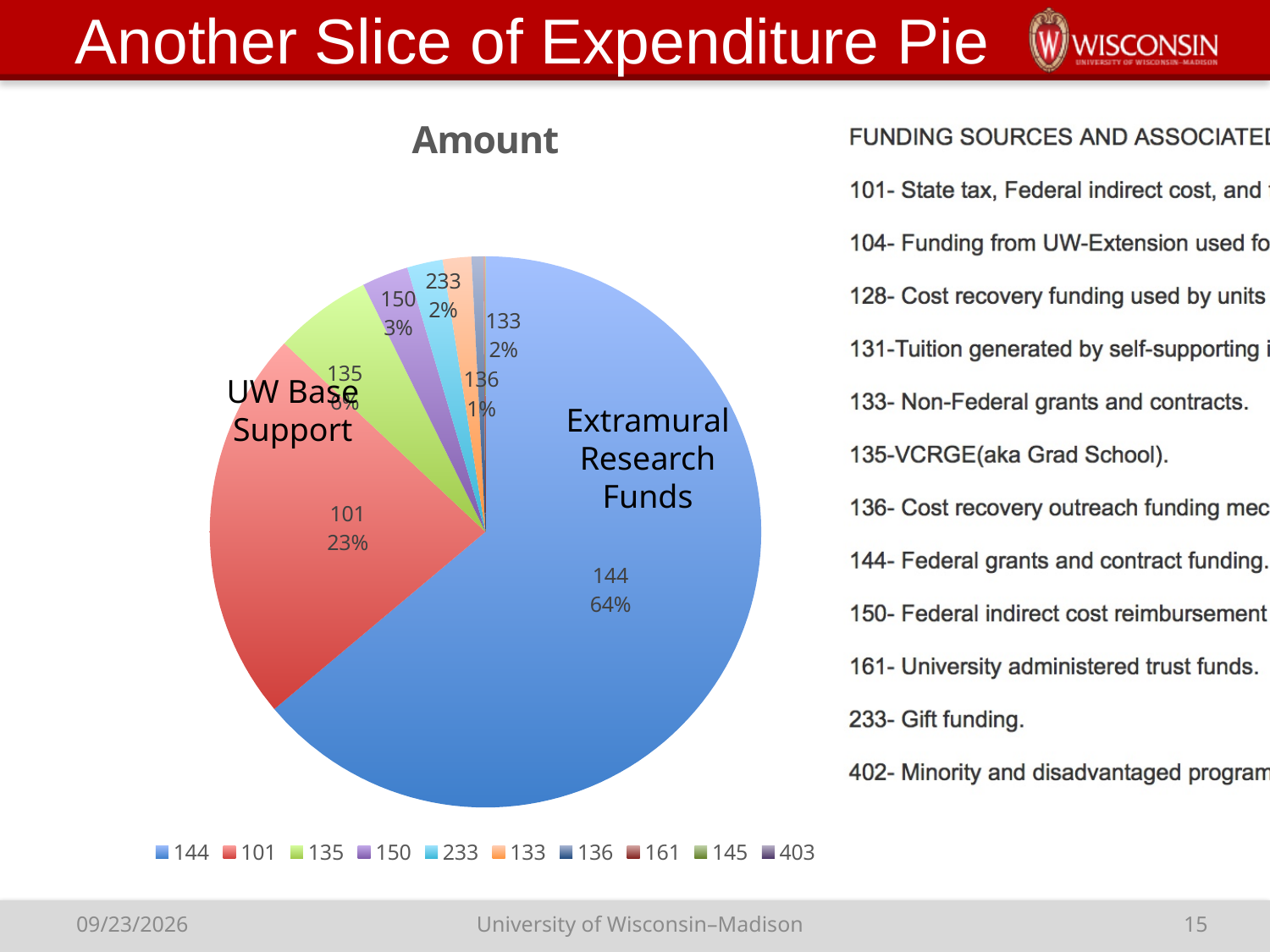
How many entries does the chart legend list? 10 What is the title of the chart? Amount What percentage share does fund 136 have in the pie chart? 1% What percentage share does fund 144 have in the pie chart? 64% What percentage share does fund 233 have in the pie chart? 2% What text label is placed over the largest slice of the pie chart? Extramural Research Funds What percentage share does fund 101 have in the pie chart? 23% Which fund has the largest slice of the pie chart? 144 How many percentage points larger is the share of fund 144 than the share of fund 101? 41 What kind of chart is shown on the slide? pie chart Which slice is larger, fund 101 or fund 150? 101 What percentage share does fund 150 have in the pie chart? 3%